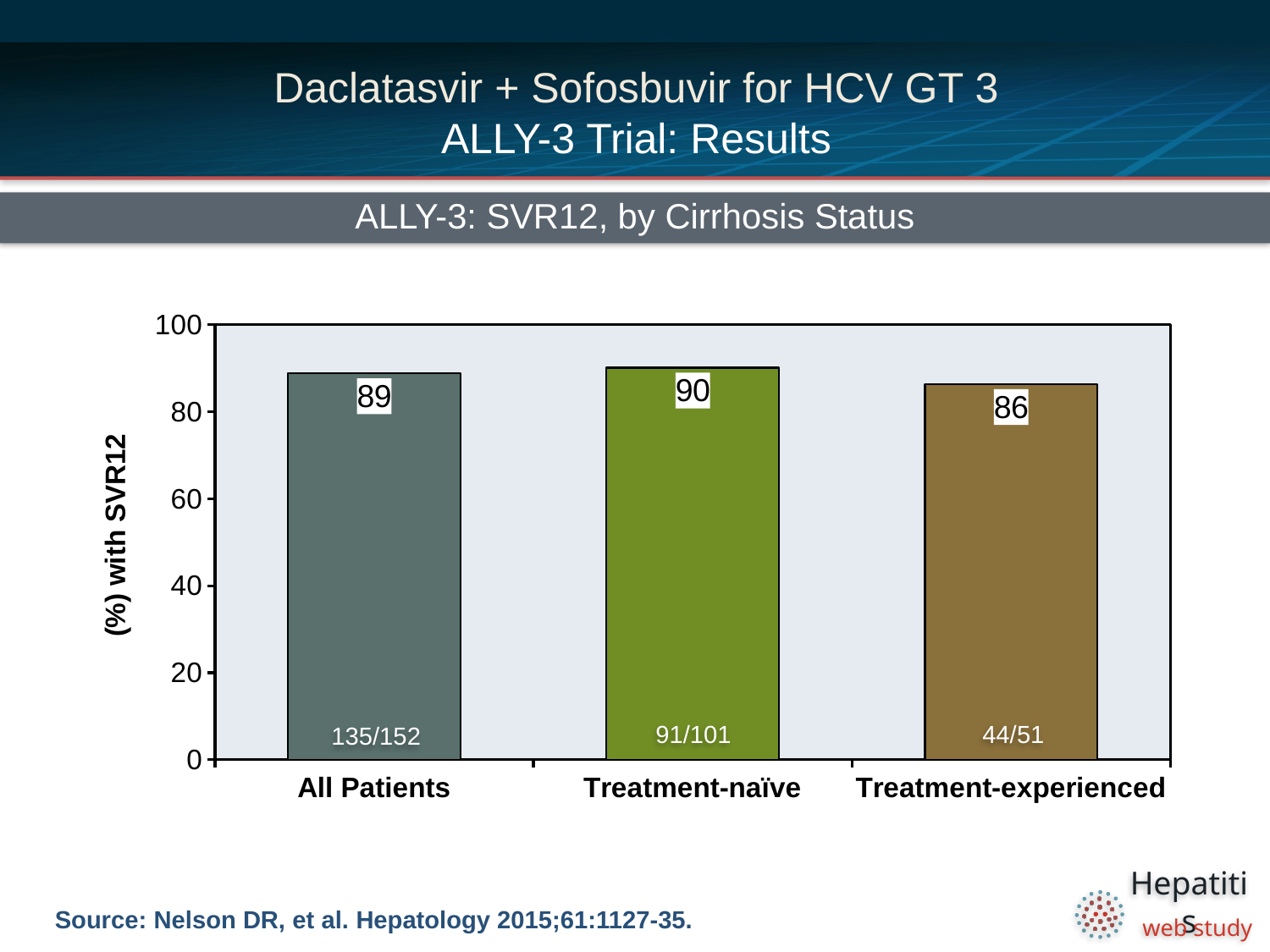
Which category has the lowest SVR12 value? Treatment-experienced What is the difference between the SVR12 values for Treatment-naïve and Treatment-experienced patients? 4 Is the SVR12 value for Treatment-experienced patients greater or less than 80? greater What is the title of the chart? ALLY-3: SVR12, by Cirrhosis Status Which is larger, the SVR12 value for All Patients or for Treatment-experienced patients? All Patients What kind of chart is shown on the slide? bar chart What fraction is printed at the bottom of the Treatment-naïve bar? 91/101 What is the SVR12 value for Treatment-naïve patients? 90 What is the SVR12 value for All Patients? 89 Which category has the highest SVR12 value? Treatment-naïve What is the SVR12 value for Treatment-experienced patients? 86 How many categories are shown on the x axis? 3